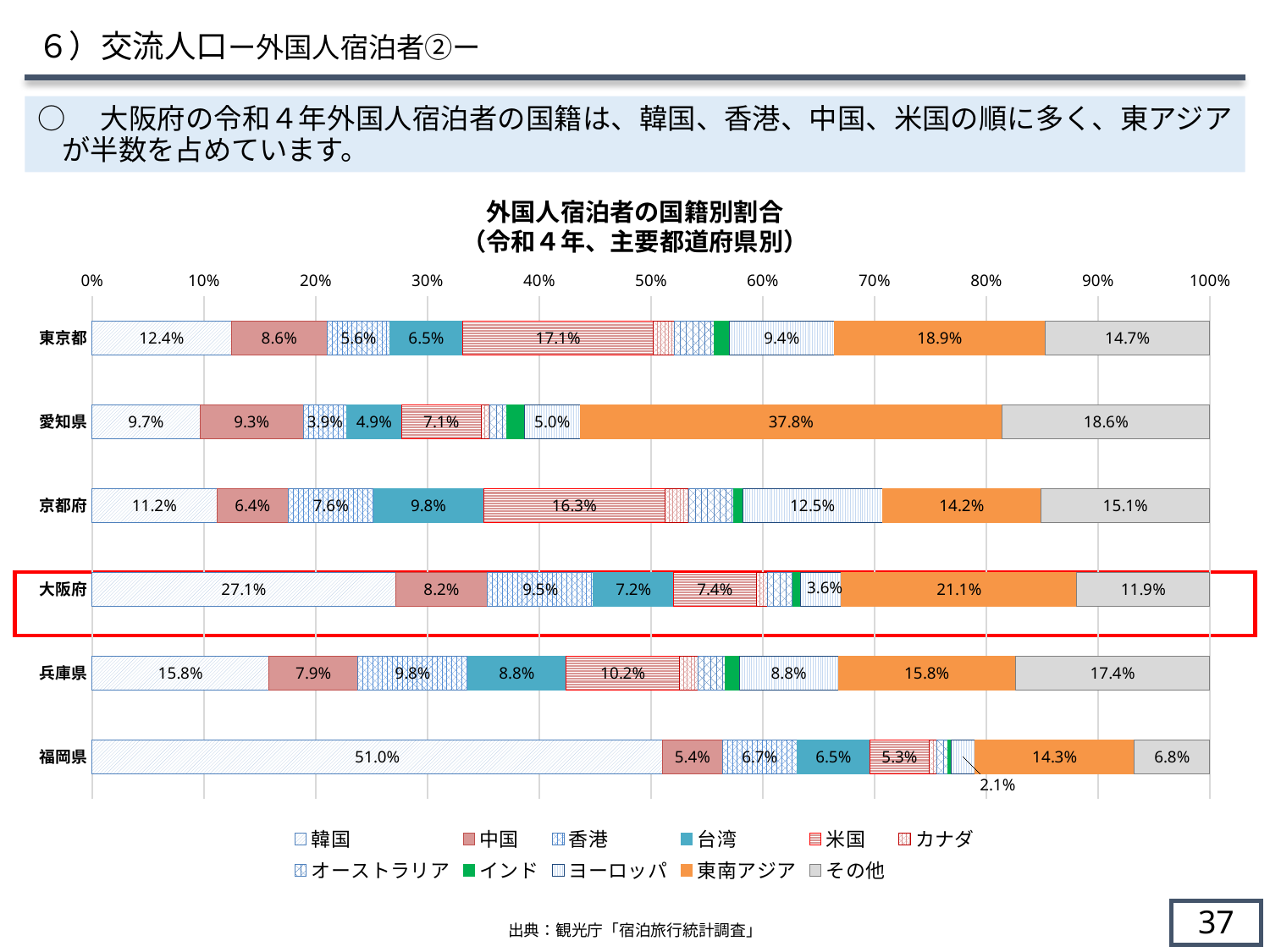
What kind of chart is shown on the slide? Stacked bar chart Which prefecture has the highest share of 韓国? 福岡県 What is the share of 米国 for 兵庫県? 10.2% How many prefectures are plotted in the chart? 6 Which series has the largest share for 愛知県? 東南アジア Which prefecture has the lowest share of その他? 福岡県 Which has the larger 米国 share, 東京都 or 京都府? 東京都 For 東京都, what is the difference between the 東南アジア share and the その他 share? 4.2% What is the share of 東南アジア for 愛知県? 37.8% What is the title of the chart? 外国人宿泊者の国籍別割合（令和４年、主要都道府県別） How many series does the legend list? 11 What is the share of 韓国 for 大阪府? 27.1%